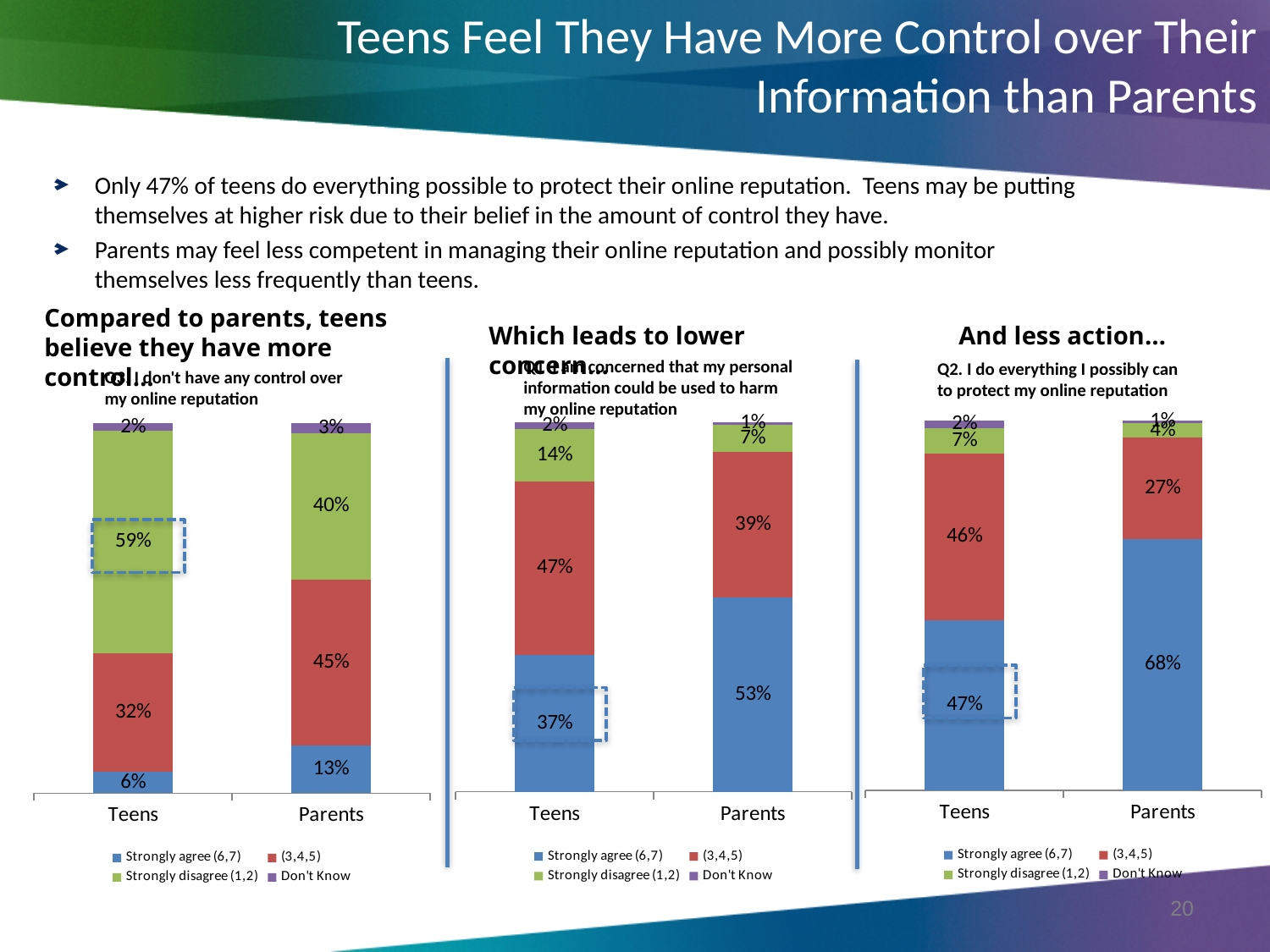
What type of chart is the middle chart (Q3)? Stacked bar chart How many series does the legend of the left chart (Q1) list? 4 How many categories are shown on the x axis of the right chart (Q2)? 2 In the middle chart (Q3), which segment of the Parents bar is the smallest? Don't Know In the right chart (Q2. I do everything I possibly can to protect my online reputation), what percentage of teens strongly agree? 47% In the right chart (Q2), which group has the larger Strongly agree share, teens or parents? Parents In the middle chart (Q3), what is the difference between the (3,4,5) share for teens and for parents? 8% In the left chart (Q1), which segment of the Teens bar is the largest? Strongly disagree (1,2) In the middle chart (Q3. I am concerned that my personal information could be used to harm my online reputation), what percentage of parents strongly agree? 53% In the left chart (Q1. I don't have any control over my online reputation), what percentage of parents strongly agree? 13% In the left chart (Q1. I don't have any control over my online reputation), what percentage of teens strongly disagree? 59% In the right chart (Q2), what is the difference between the Strongly agree share for parents and for teens? 21%